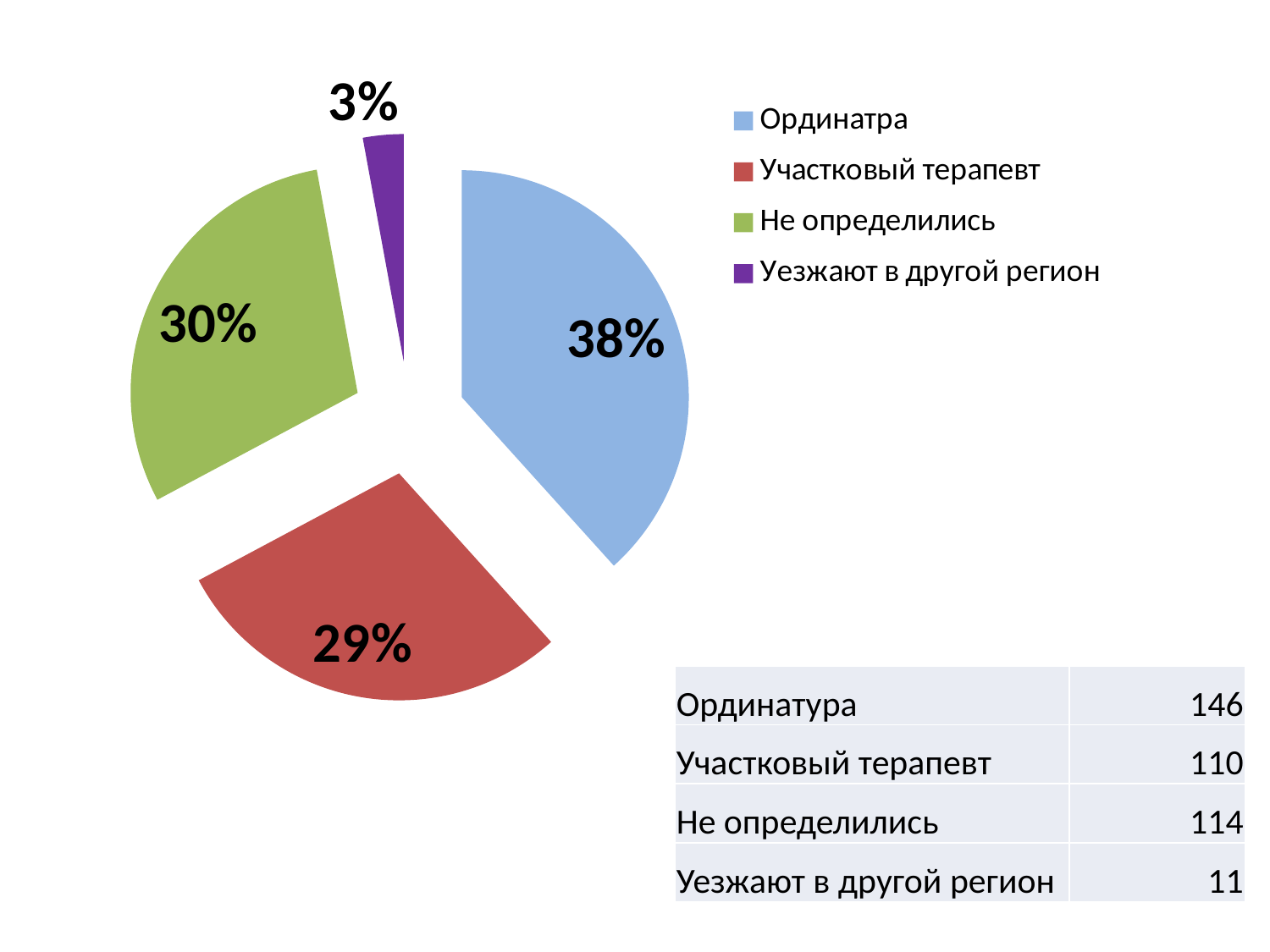
Which slice is larger, Не определились or Уезжают в другой регион? Не определились What colour is the slice for Участковый терапевт? red How many entries does the legend list? 4 What kind of chart is shown on the slide? pie chart Which category has the largest slice of the pie? Ординатра What share of the pie does the slice for Ординатра have? 38% How many slices does the pie chart have? 4 Which category has the smallest slice of the pie? Уезжают в другой регион What share of the pie does the slice for Уезжают в другой регион have? 3% What is the difference in percentage points between the Ординатра slice and the Участковый терапевт slice? 9 What share of the pie does the slice for Участковый терапевт have? 29%